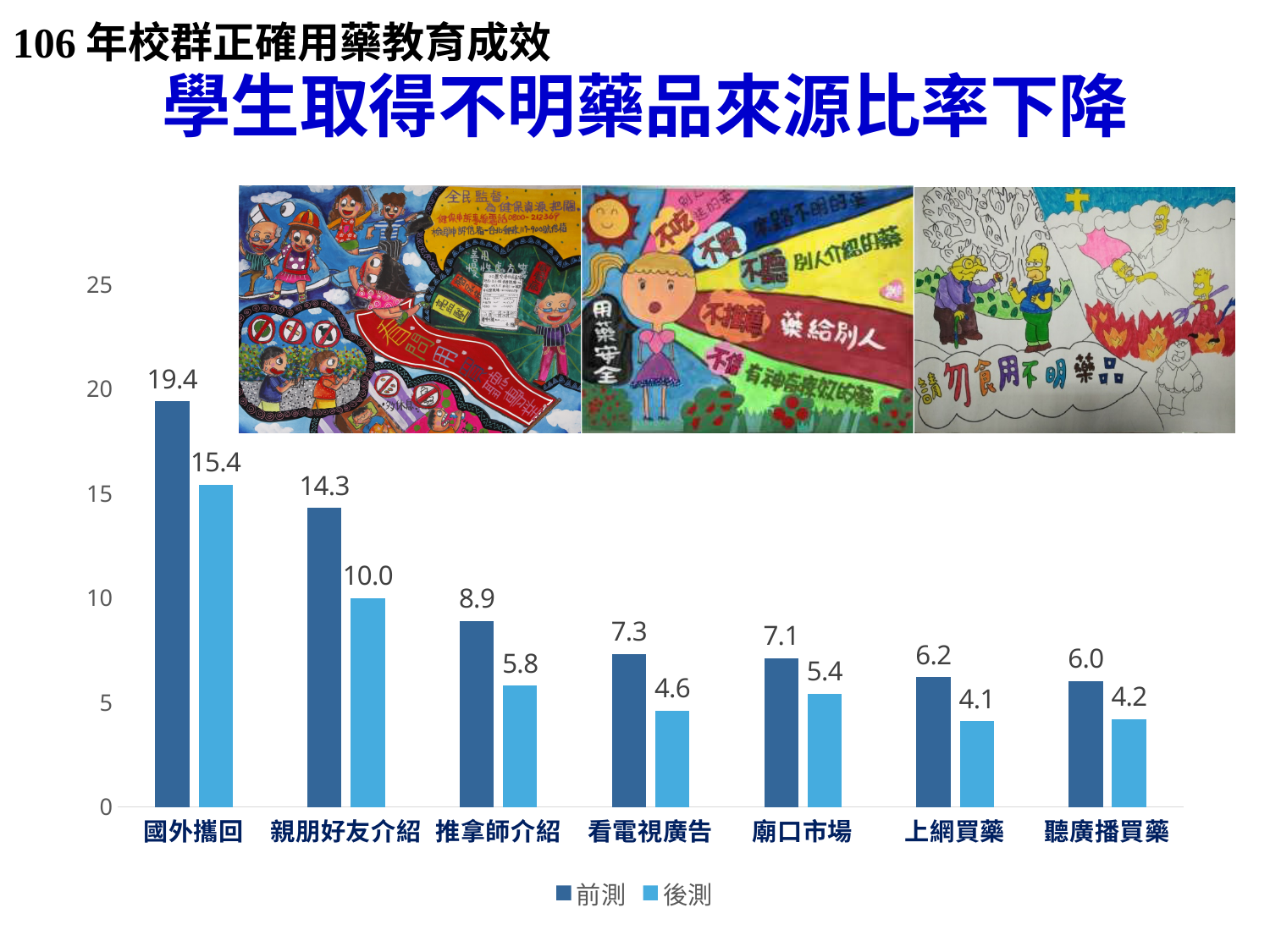
What is the 後測 value for 親朋好友介紹? 10.0 What is the 後測 value for 推拿師介紹? 5.8 How many categories are shown on the x axis? 7 Which is larger, the 後測 value for 看電視廣告 or the 後測 value for 廟口市場? 廟口市場 Which category has the lowest 後測 value? 上網買藥 What kind of chart is shown on the slide? Bar chart What is the difference between the 前測 and 後測 values for 國外攜回? 4.0 What are the two series named in the legend? 前測 and 後測 What is the 前測 value for 廟口市場? 7.1 Which category has the highest 前測 value? 國外攜回 How many series does the legend list? 2 What is the 前測 value for 國外攜回? 19.4